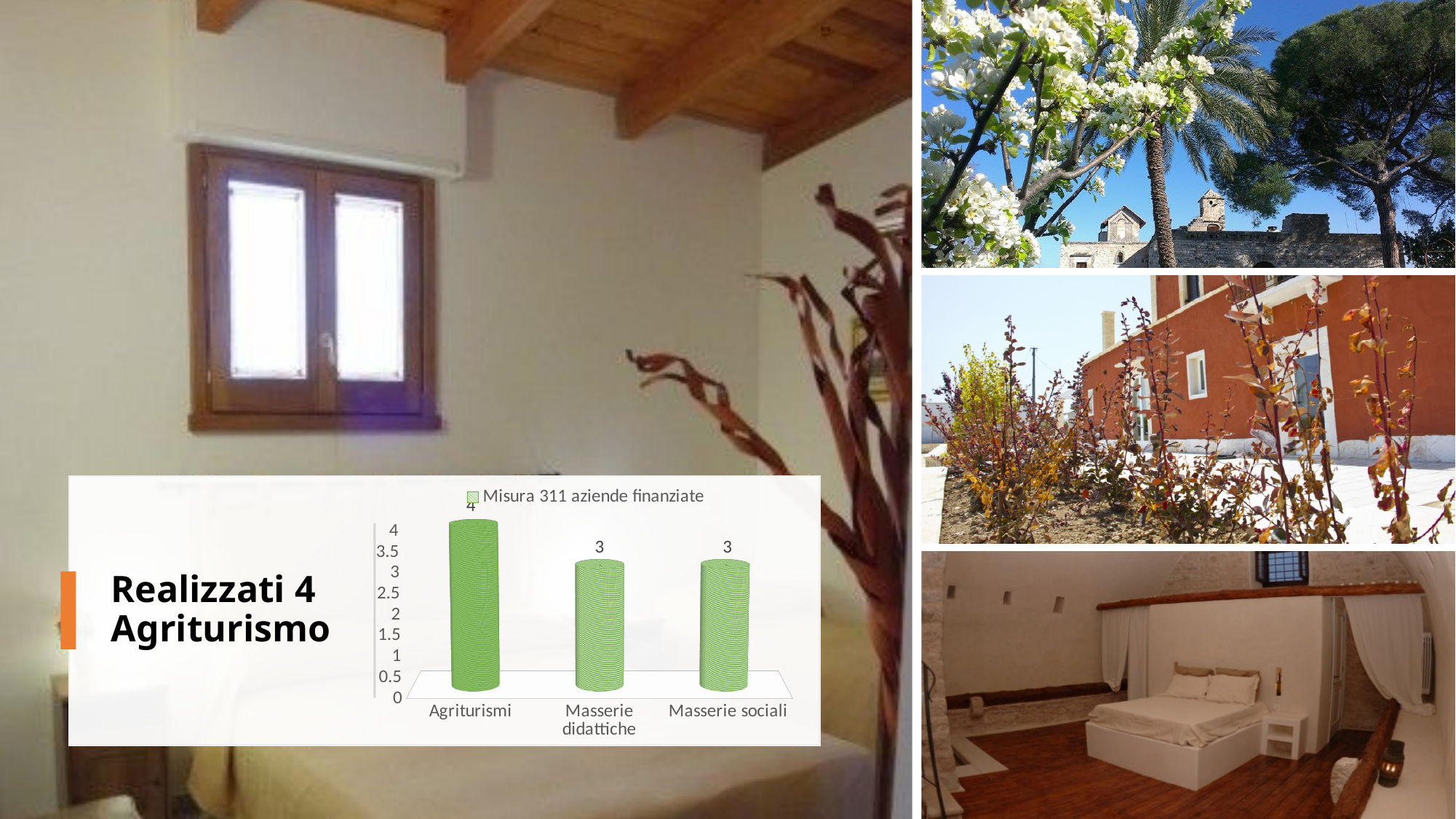
What kind of chart is shown? bar chart Is the value for Agriturismi greater or less than 3.5? greater What is the difference between the values for Agriturismi and Masserie didattiche? 1 How many categories are shown on the x axis? 3 What is the value for Agriturismi? 4 Which category has the highest value? Agriturismi What is the value for Masserie didattiche? 3 Which is larger, the value for Agriturismi or the value for Masserie sociali? Agriturismi What is the total of the values for all three categories? 10 How many series does the legend list? 1 What is the name of the series shown in the legend? Misura 311 aziende finanziate What is the value for Masserie sociali? 3